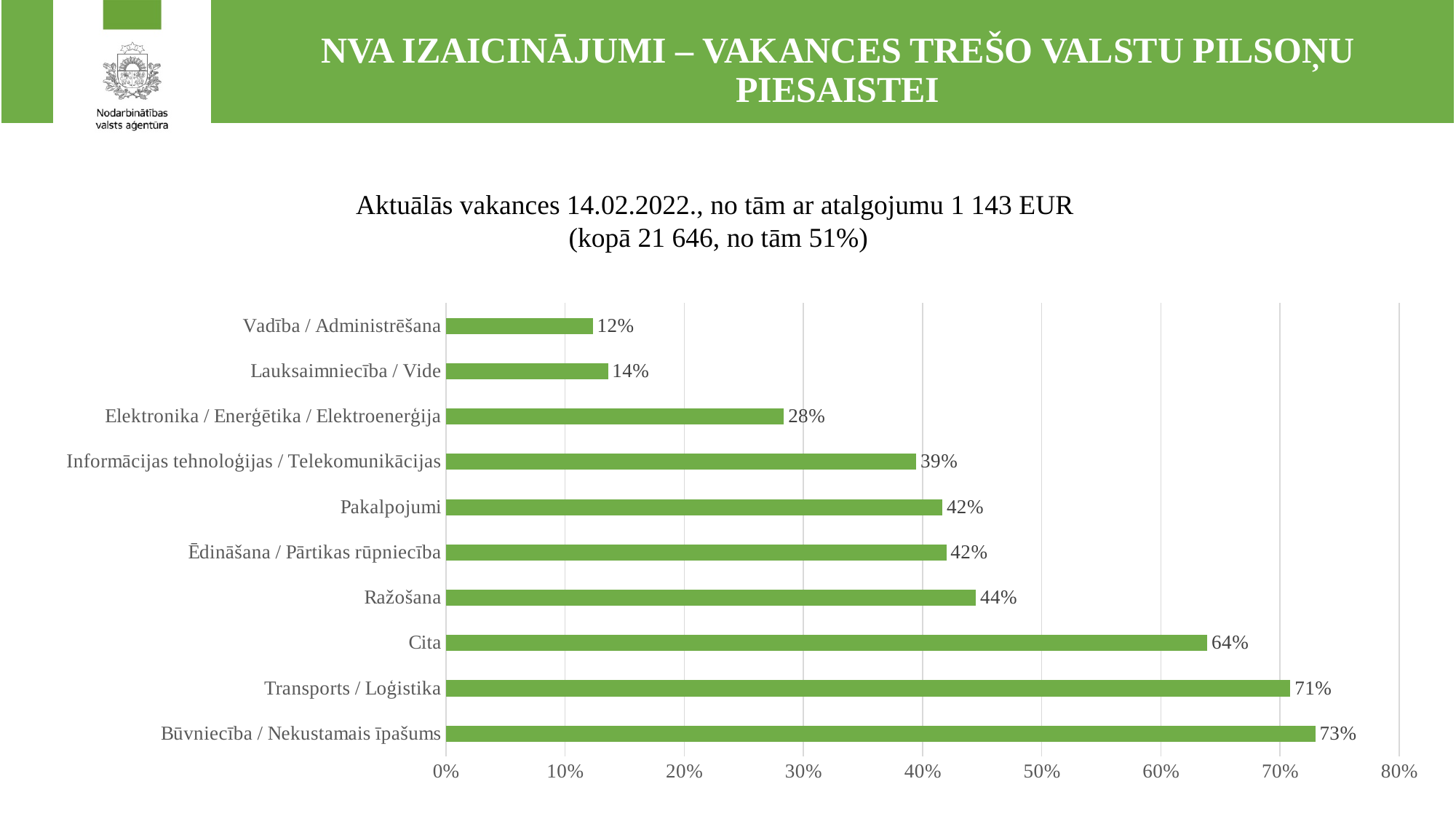
Which category has the lowest value? Vadība / Administrēšana What is the value for Būvniecība / Nekustamais īpašums? 73% Is the value for Cita greater or less than 60%? greater What is the value for Lauksaimniecība / Vide? 14% Which category has the highest value? Būvniecība / Nekustamais īpašums What is the difference between the values for Transports / Loģistika and Cita? 7% What kind of chart is shown on the slide? bar chart What is the difference between the values for Pakalpojumi and Vadība / Administrēšana? 30% Which is larger, the value for Ražošana or the value for Elektronika / Enerģētika / Elektroenerģija? Ražošana What is the title of the chart? Aktuālās vakances 14.02.2022., no tām ar atalgojumu 1 143 EUR (kopā 21 646, no tām 51%) How many categories are shown in the chart? 10 What is the value for Informācijas tehnoloģijas / Telekomunikācijas? 39%